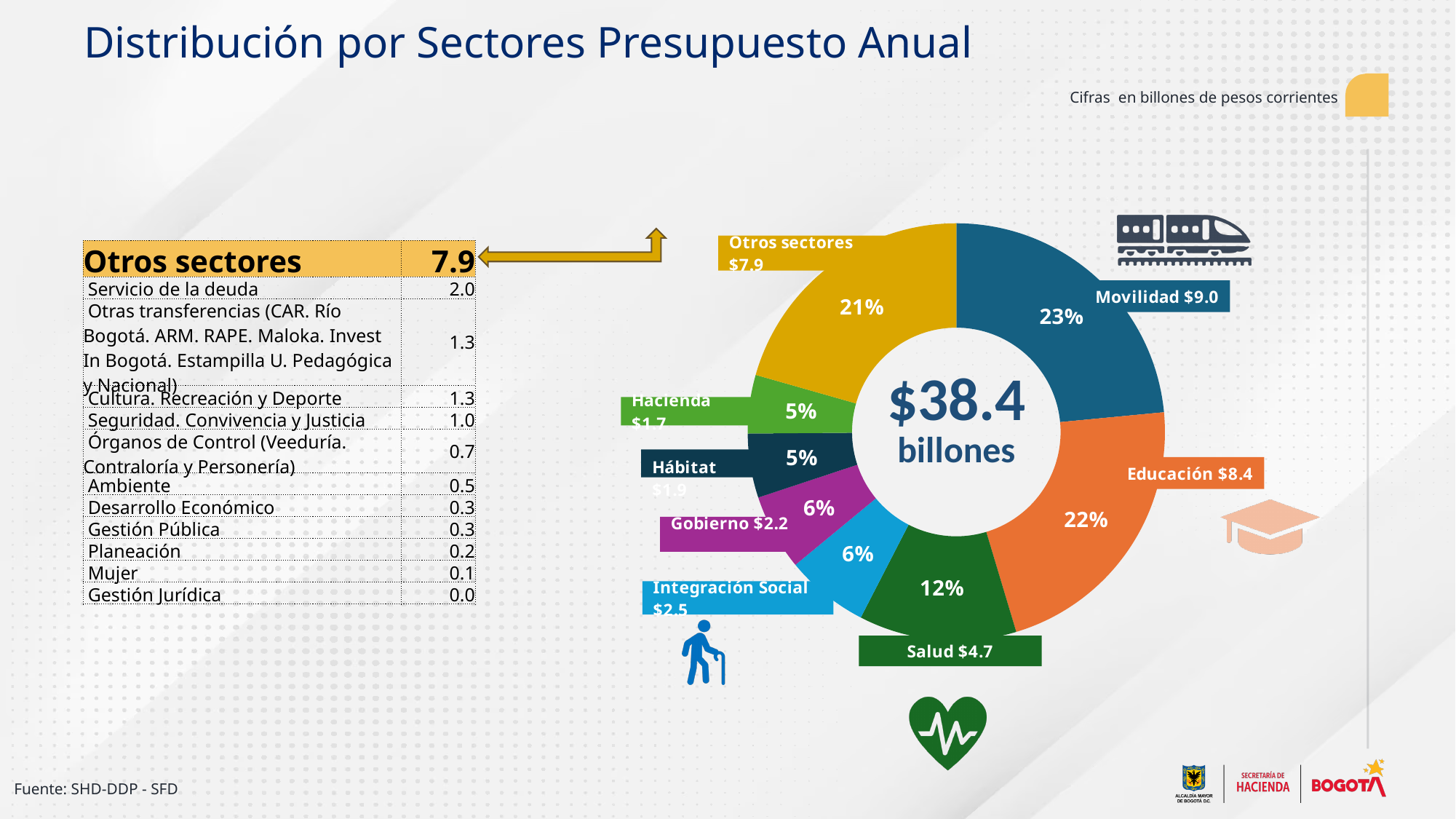
What is the value shown for Educación in the pie chart? $8.4 What is the value shown for Salud in the pie chart? $4.7 Which sector has the smallest value in the pie chart? Hacienda Which sector has the largest slice in the pie chart? Movilidad What percentage share does Salud have in the pie chart? 12% What kind of chart is shown on the slide? Pie chart (donut) How many sectors are shown as slices in the pie chart? 8 Which is larger in the pie chart, Integración Social or Gobierno? Integración Social What total amount is shown in the center of the pie chart? $38.4 billones What percentage share does Otros sectores have in the pie chart? 21% What is the difference between the values for Movilidad and Educación in the pie chart? $0.6 What is the value shown for Movilidad in the pie chart? $9.0